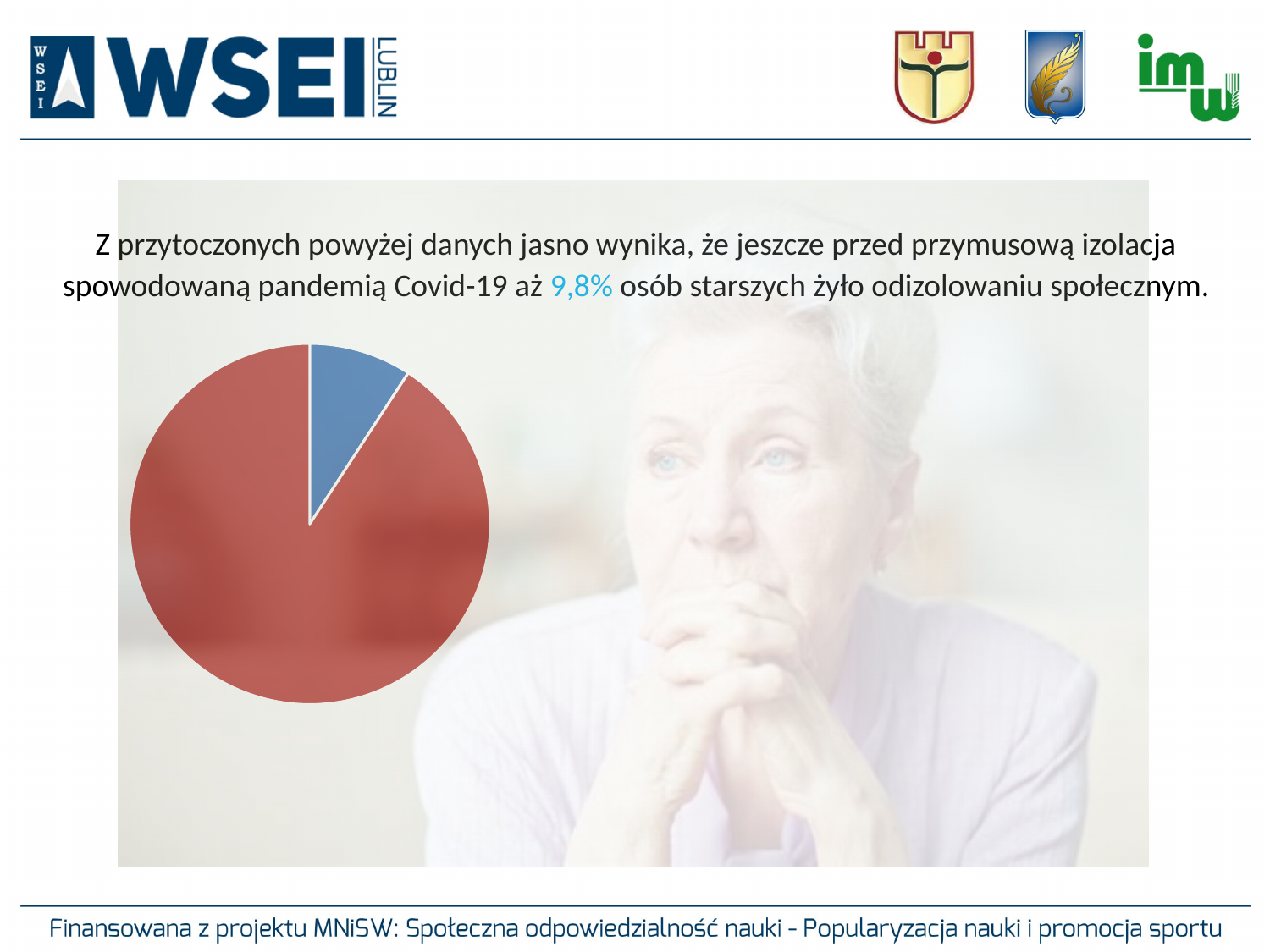
Which slice is larger in the pie chart, the red one or the blue one? red Which colour slice is the largest in the pie chart? red How many slices does the pie chart have? 2 Does the pie chart show data labels on its slices? no What kind of chart is shown on the slide? pie chart Does the red slice take up more or less than half of the pie chart? more Does the pie chart display a legend? no Which colour slice is the smallest in the pie chart? blue Does the blue slice take up more or less than half of the pie chart? less